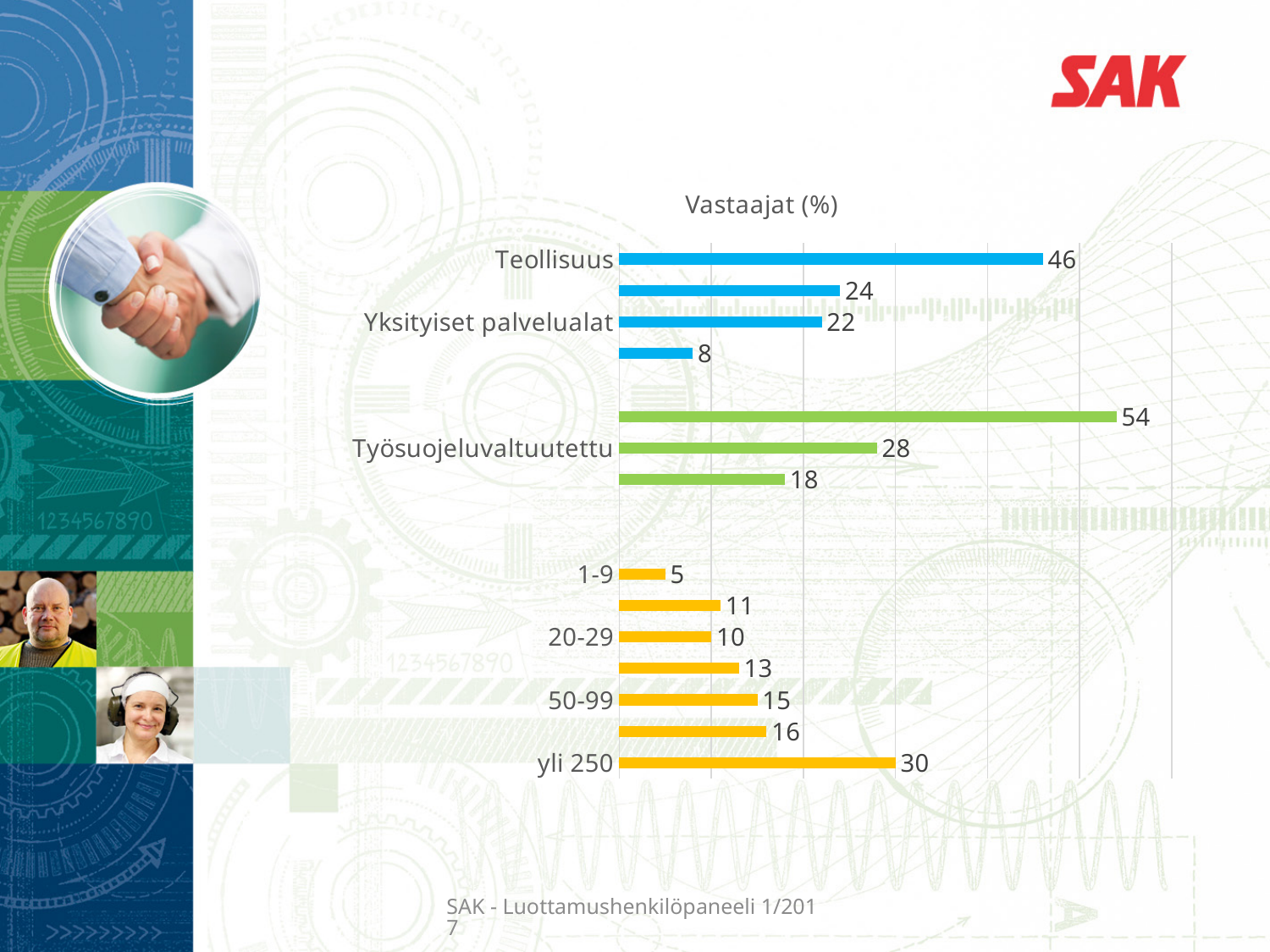
What is the largest value labelled on the chart? 54 What is the value for the 50-99 category? 15 What is the value for the 1-9 category? 5 What is the value for Yksityiset palvelualat? 22 What is the value for the 20-29 category? 10 What is the difference between the values for yli 250 and 1-9? 25 Which has a larger value, 50-99 or 20-29? 50-99 What is the difference between the values for Teollisuus and Yksityiset palvelualat? 24 What is the value for yli 250? 30 What kind of chart is shown on the slide? bar chart What is the value for Työsuojeluvaltuutettu? 28 What is the value for Teollisuus? 46